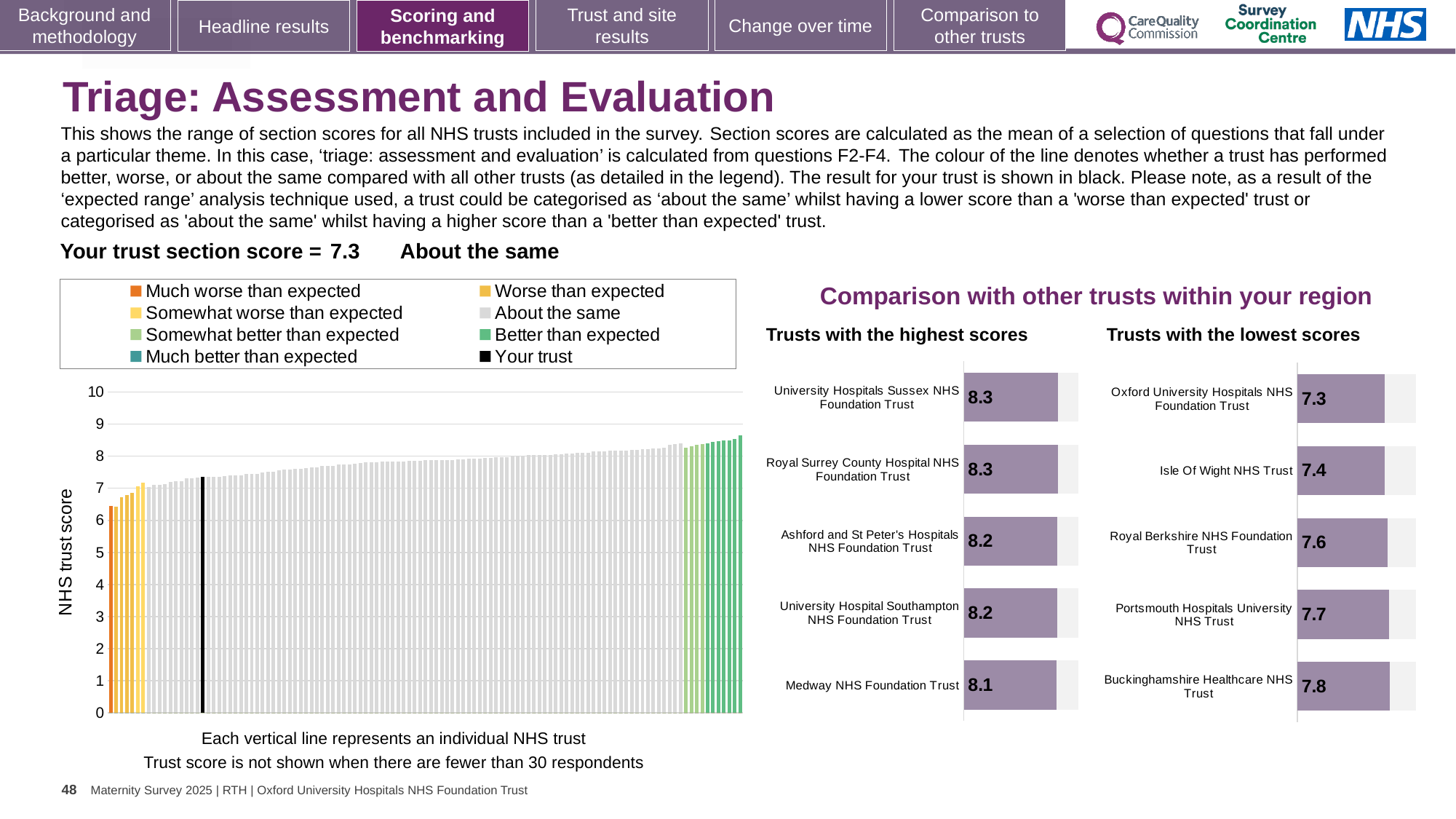
In the large chart on the left, is the value of the black bar (your trust) greater or less than 7? greater What is the y-axis label of the large chart on the left? NHS trust score What kind of chart is the large chart on the left showing NHS trust scores? Bar chart In the 'Trusts with the highest scores' chart, what is the score for Medway NHS Foundation Trust? 8.1 In the large chart on the left, do the trust scores rise or fall from left to right? Rise In the 'Trusts with the lowest scores' chart, which has the higher score: Isle Of Wight NHS Trust or Portsmouth Hospitals University NHS Trust? Portsmouth Hospitals University NHS Trust How many trusts are listed in the 'Trusts with the highest scores' chart? 5 In the 'Trusts with the highest scores' chart, which trust has the lowest score? Medway NHS Foundation Trust In the 'Trusts with the lowest scores' chart, what is the difference between the scores of Buckinghamshire Healthcare NHS Trust and Oxford University Hospitals NHS Foundation Trust? 0.5 In the 'Trusts with the lowest scores' chart, what is the score for Royal Berkshire NHS Foundation Trust? 7.6 How many entries does the legend of the large chart on the left list? 8 In the 'Trusts with the lowest scores' chart, which trust has the lowest score? Oxford University Hospitals NHS Foundation Trust